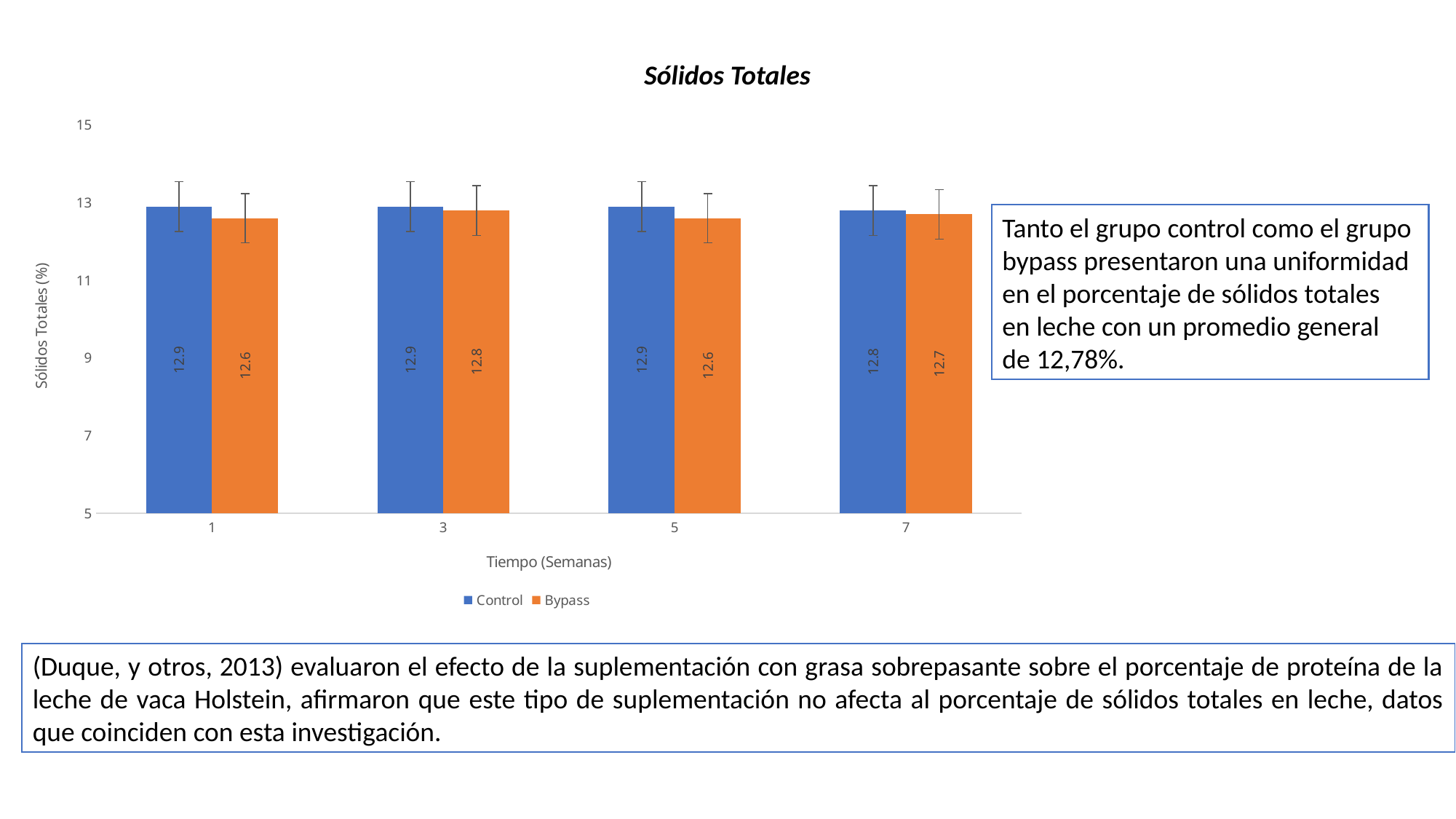
How many series does the legend list? 2 What is the difference between the Control and Bypass values at week 5? 0.3 Is the Control value at week 1 greater or less than 11? greater What is the title of the chart? Sólidos Totales What is the Control value at week 7? 12.8 What is the Bypass value at week 7? 12.7 What kind of chart is shown? bar chart What is the difference between the Control and Bypass values at week 1? 0.3 How many time points (weeks) are shown on the x axis? 4 At week 3, which series has the larger value, Control or Bypass? Control What is the Control value at week 1? 12.9 What is the Bypass value at week 3? 12.8